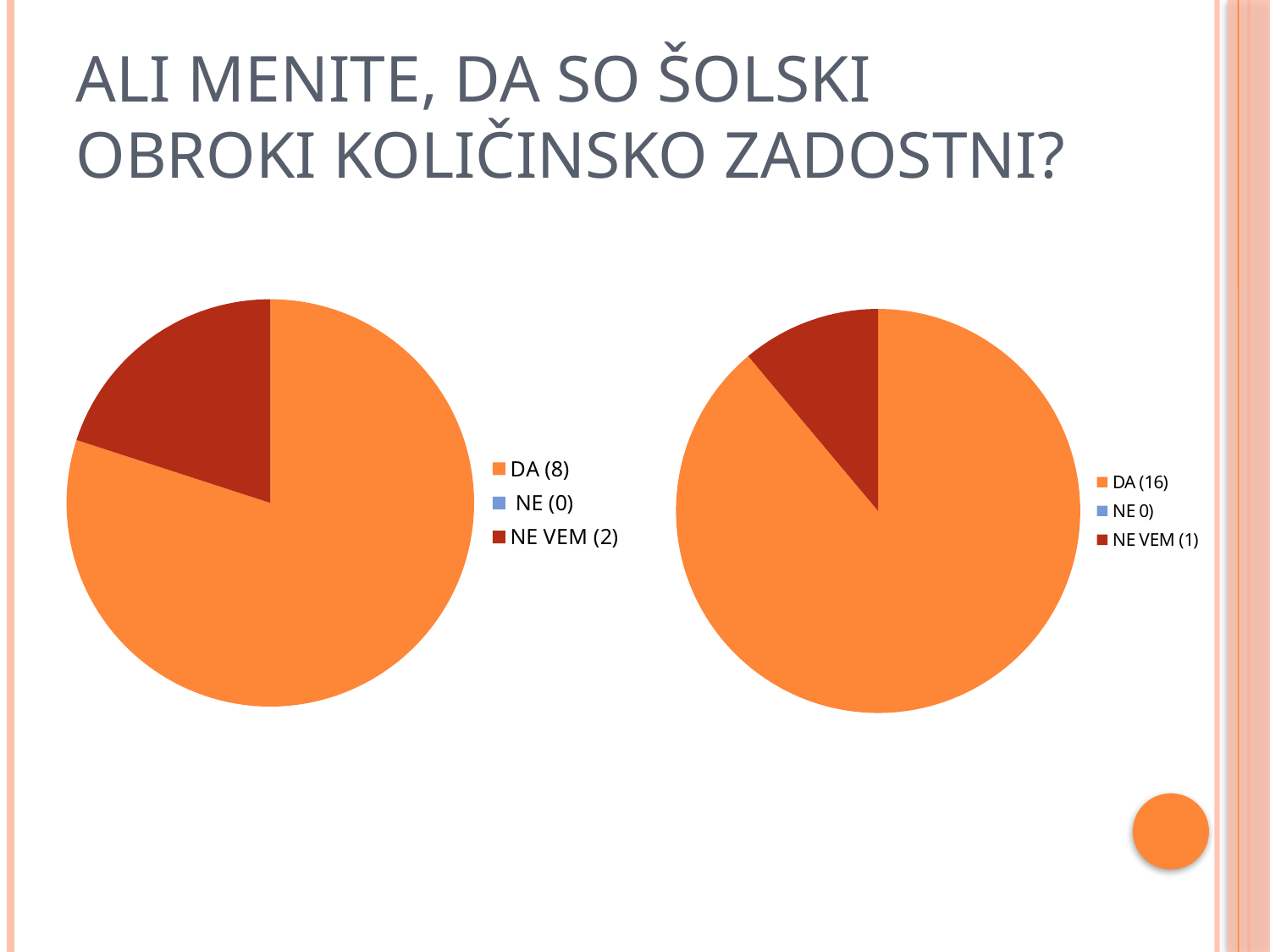
In the left pie chart, what colour is the NE VEM slice? dark red In the right pie chart, how many respondents answered NE VEM according to the legend? 1 In the left pie chart, what is the difference between the DA count and the NE VEM count? 6 In the left pie chart, what share of the total responses does DA represent? 80% Which is larger: the DA count in the left pie chart or the DA count in the right pie chart? the right pie chart In the right pie chart, how many respondents answered DA according to the legend? 16 In the right pie chart, which category has the smallest value in the legend? NE In the left pie chart, how many respondents answered DA according to the legend? 8 How many entries does the legend of the right pie chart list? 3 What type of chart is the left chart on the slide? pie chart In the left pie chart, which category has the largest slice? DA In the left pie chart, how many respondents answered NE VEM according to the legend? 2